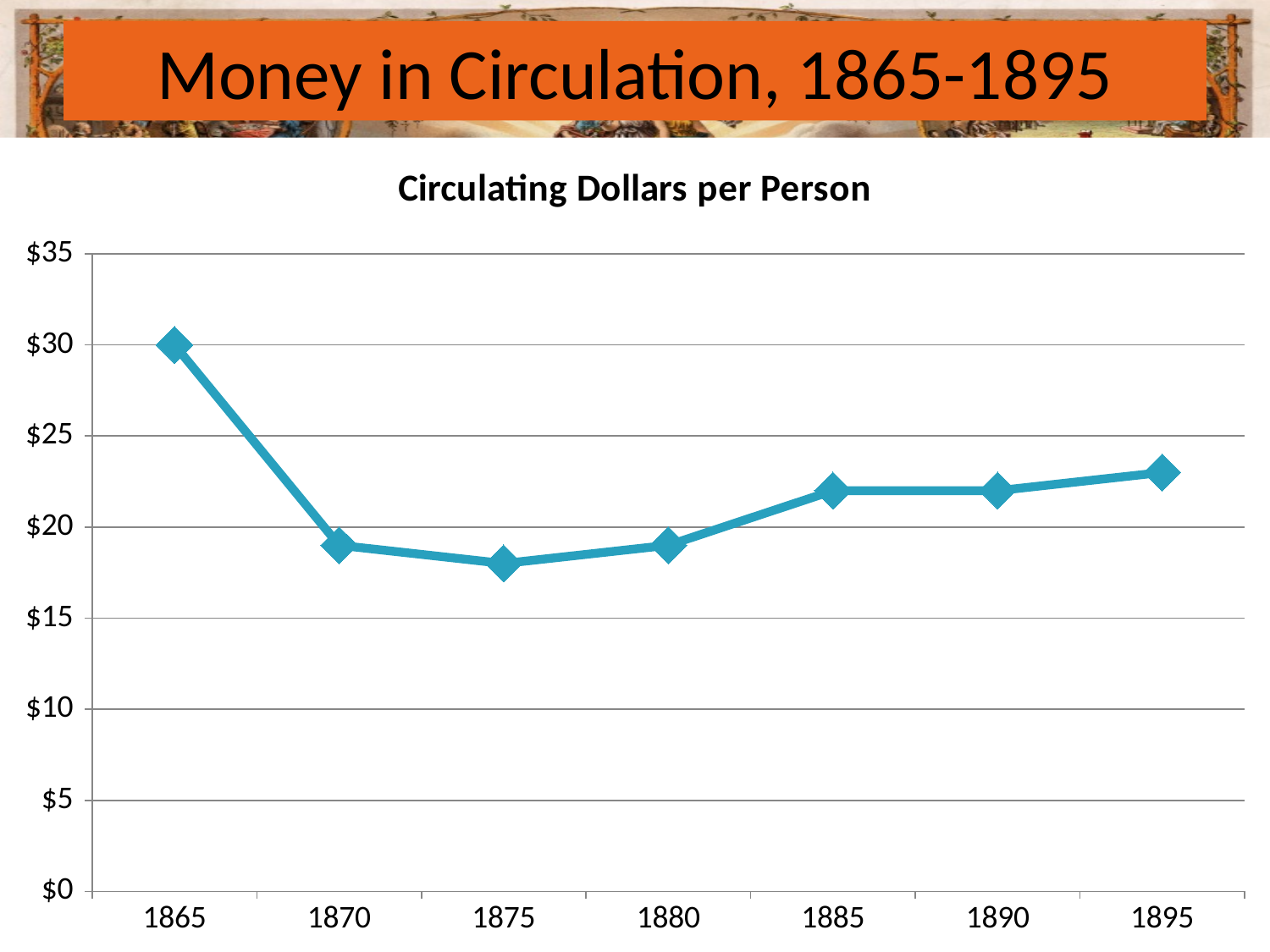
Does the value rise or fall between 1865 and 1870? fall Which year has a larger value, 1865 or 1870? 1865 What is the title of the chart? Circulating Dollars per Person Which year has the lowest circulating dollars per person? 1875 Which year has the highest circulating dollars per person? 1865 What type of chart is shown on the slide? line chart Is the value for 1870 greater or less than $20? less Is the value for 1885 greater or less than $20? greater What is the value of circulating dollars per person in 1865? $30 Is the value for 1895 greater or less than $25? less Which year has a larger value, 1875 or 1885? 1885 How many data points are plotted on the line? 7